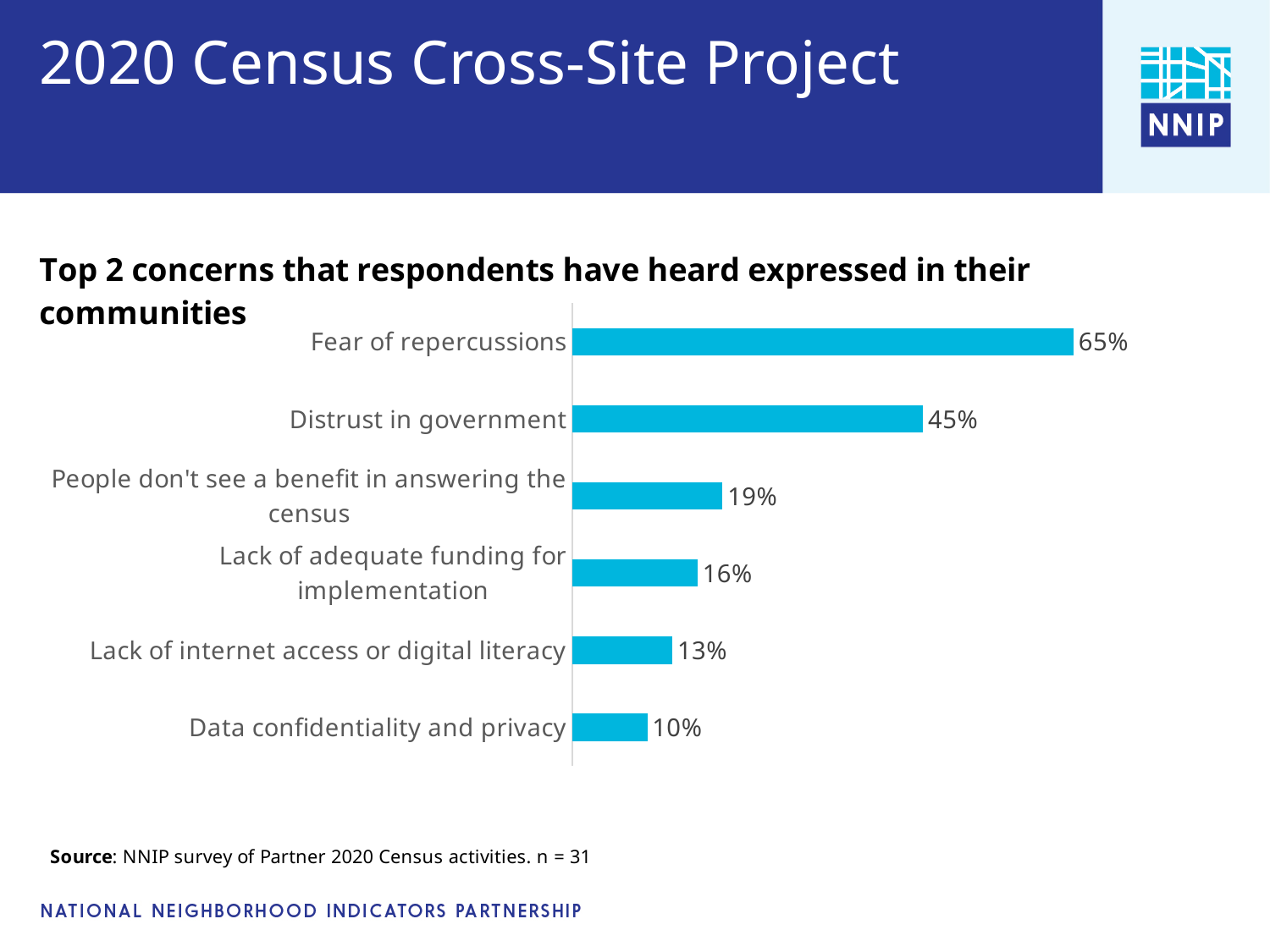
What is the value shown for 'Distrust in government'? 45% According to the source note, how many respondents (n) were surveyed? 31 What percentage is shown for 'Lack of internet access or digital literacy'? 13% What is the difference between 'People don't see a benefit in answering the census' and 'Lack of adequate funding for implementation'? 3 percentage points Which concern has the highest percentage? Fear of repercussions What percentage of respondents reported 'Fear of repercussions' as a top concern? 65% What is the title of the chart? Top 2 concerns that respondents have heard expressed in their communities What is the difference in percentage points between 'Fear of repercussions' and 'Distrust in government'? 20 What type of chart is shown on the slide? Bar chart Which is larger: 'Lack of adequate funding for implementation' or 'Data confidentiality and privacy'? Lack of adequate funding for implementation Which concern has the lowest percentage? Data confidentiality and privacy How many concerns are listed in the chart? 6